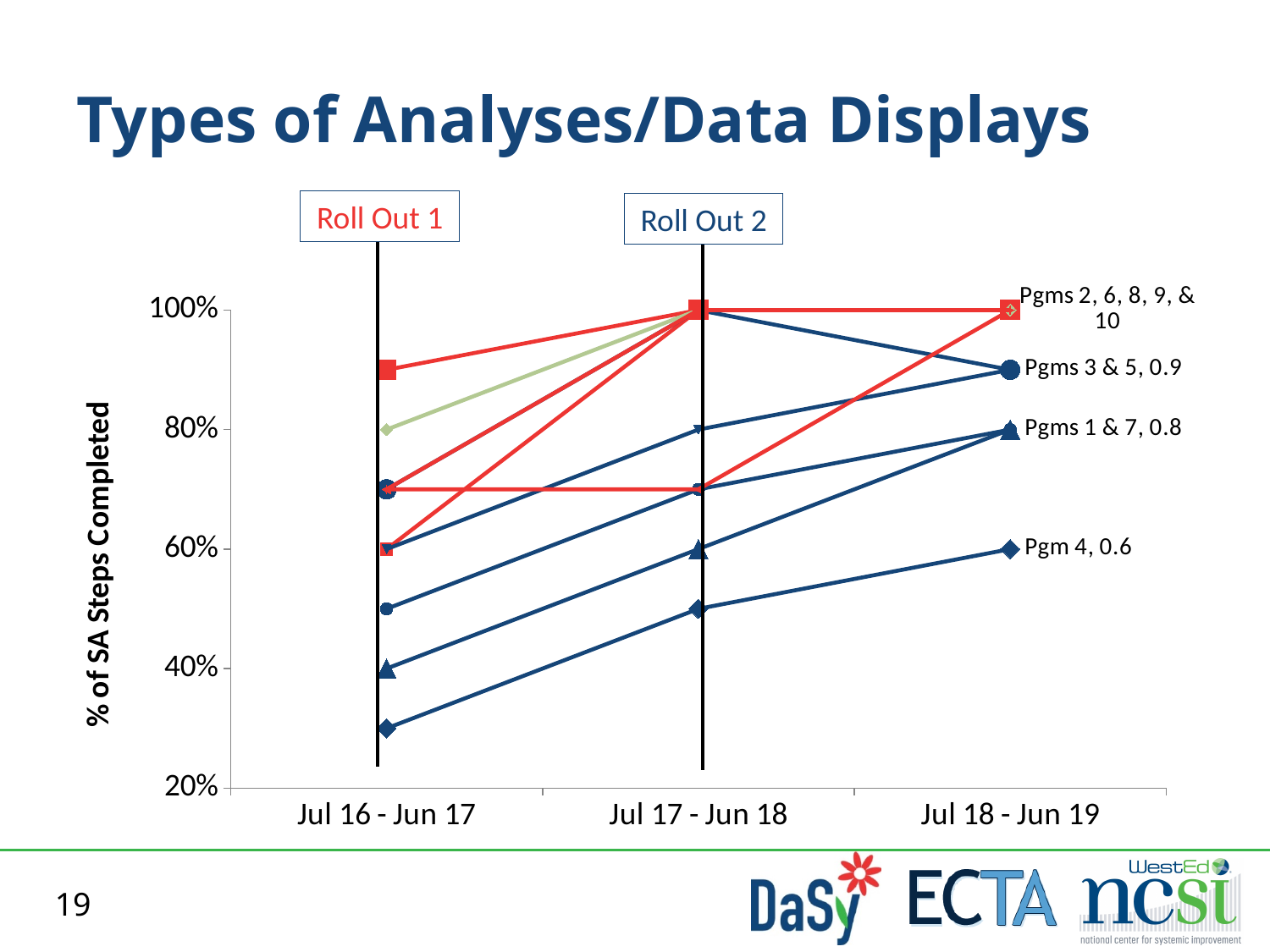
Does the line for Pgm 4 rise or fall from Jul 16 - Jun 17 to Jul 18 - Jun 19? rise Which program has the lowest value in the Jul 18 - Jun 19 period? Pgm 4 In the Jul 18 - Jun 19 period, which is larger: the value for Pgms 3 & 5 or the value for Pgms 1 & 7? Pgms 3 & 5 What type of chart is shown on the slide? line chart What is the value for Pgm 4 in the Jul 18 - Jun 19 period? 0.6 Which program group has the highest value in the Jul 18 - Jun 19 period? Pgms 2, 6, 8, 9, & 10 Is the value for Pgm 4 in the Jul 16 - Jun 17 period greater or less than 40%? less How many time periods are shown on the x axis? 3 What is the value for Pgms 3 & 5 in the Jul 18 - Jun 19 period? 0.9 What is the title of the y axis? % of SA Steps Completed What is the value for Pgms 1 & 7 in the Jul 18 - Jun 19 period? 0.8 What is the difference between the Jul 18 - Jun 19 values for Pgms 3 & 5 and Pgm 4? 0.3